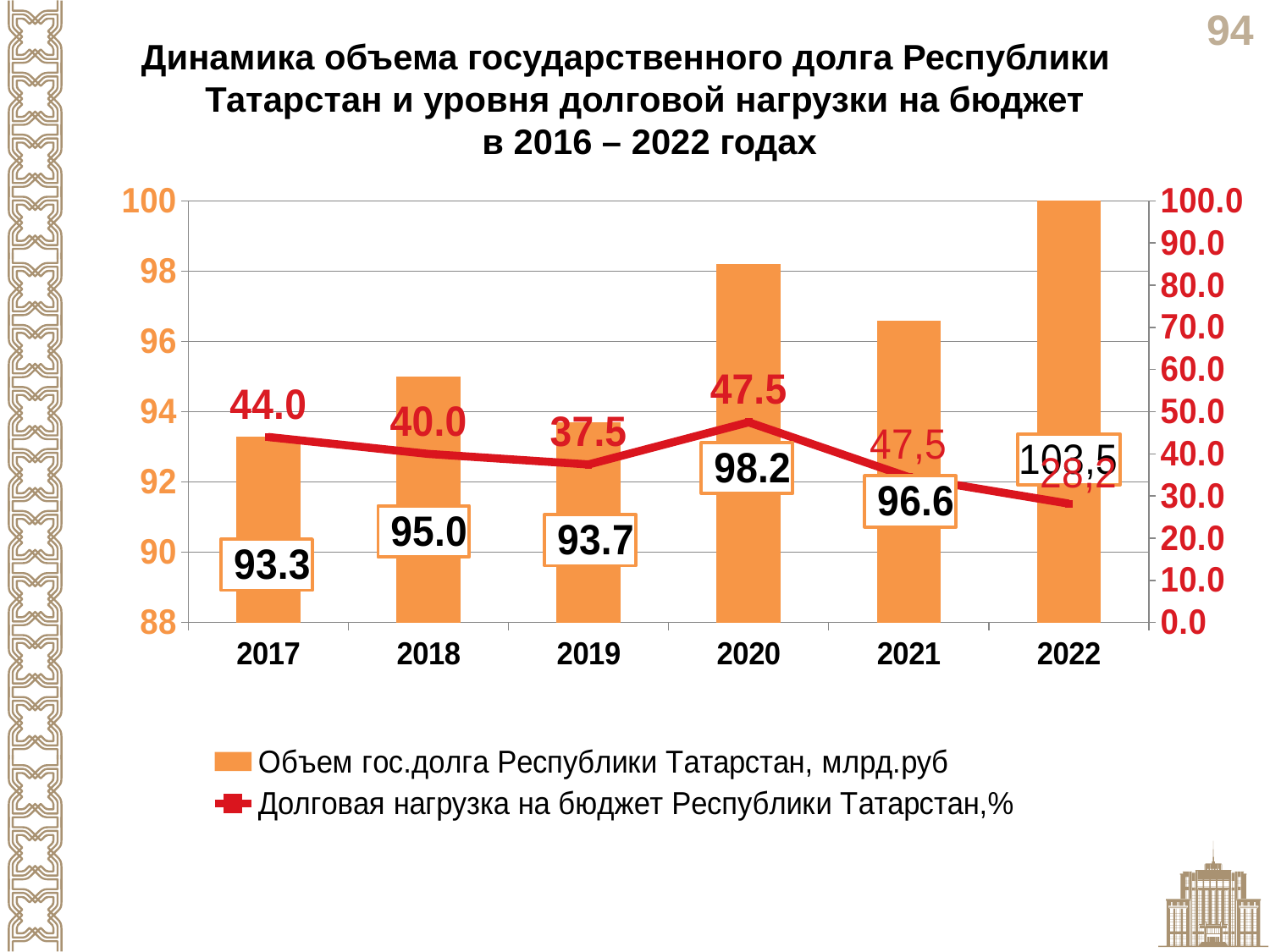
What is the volume of state debt of the Republic of Tatarstan (млрд.руб) in 2020? 98.2 How many years are shown on the x axis? 6 How many series does the legend list? 2 What is the volume of state debt (млрд.руб) in 2018? 95.0 What is the debt burden on the budget (%) in 2019? 37.5 Which year has the larger volume of state debt, 2018 or 2019? 2018 In which year is the debt burden on the budget the lowest? 2022 By how much did the volume of state debt in 2020 exceed that in 2017 (млрд.руб)? 4.9 Does the debt burden on the budget rise or fall from 2020 to 2022? fall In which year is the volume of state debt the lowest? 2017 In which year is the volume of state debt the highest? 2022 What is the debt burden on the budget (%) in 2022? 28,2